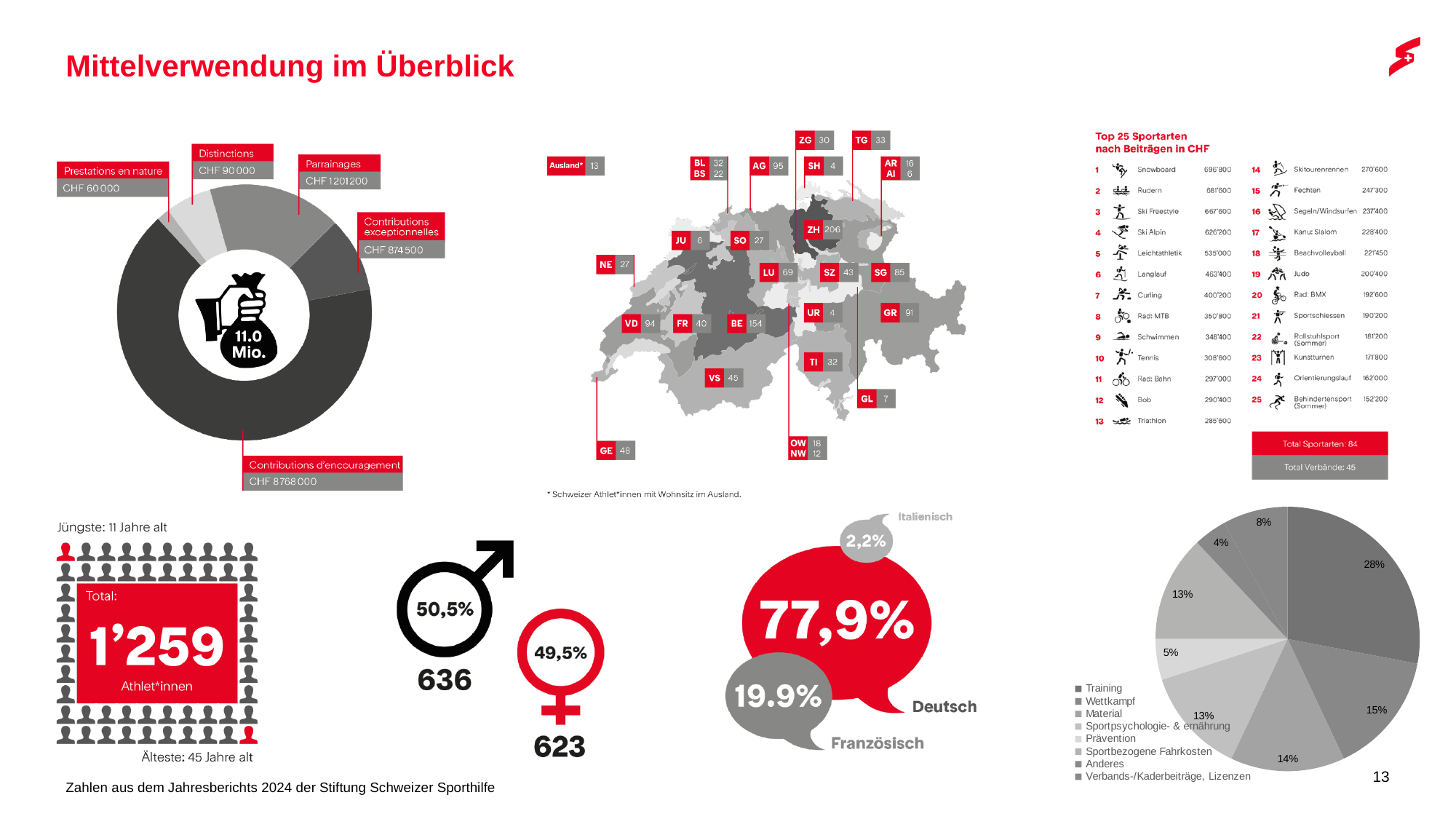
How many categories does the donut chart on the left show? 5 In the pie chart at the bottom right, what is the smallest slice's percentage? 4% What total is printed in the centre of the donut chart on the left? 11.0 Mio. In the donut chart on the left, what is the difference between Distinctions and Prestations en nature? CHF 30 000 In the donut chart on the left, what is the value for Contributions d'encouragement? CHF 8 768 000 In the donut chart on the left, which category has the highest value? Contributions d'encouragement In the donut chart on the left, what is the value for Parrainages? CHF 1 201 200 On the map of Switzerland, what value is shown for ZH? 206 In the pie chart at the bottom right, what is the largest slice's percentage? 28% What kind of chart is shown at the bottom right of the slide? Pie chart In the donut chart on the left, which category has the lowest value? Prestations en nature How many entries does the legend of the pie chart at the bottom right list? 8